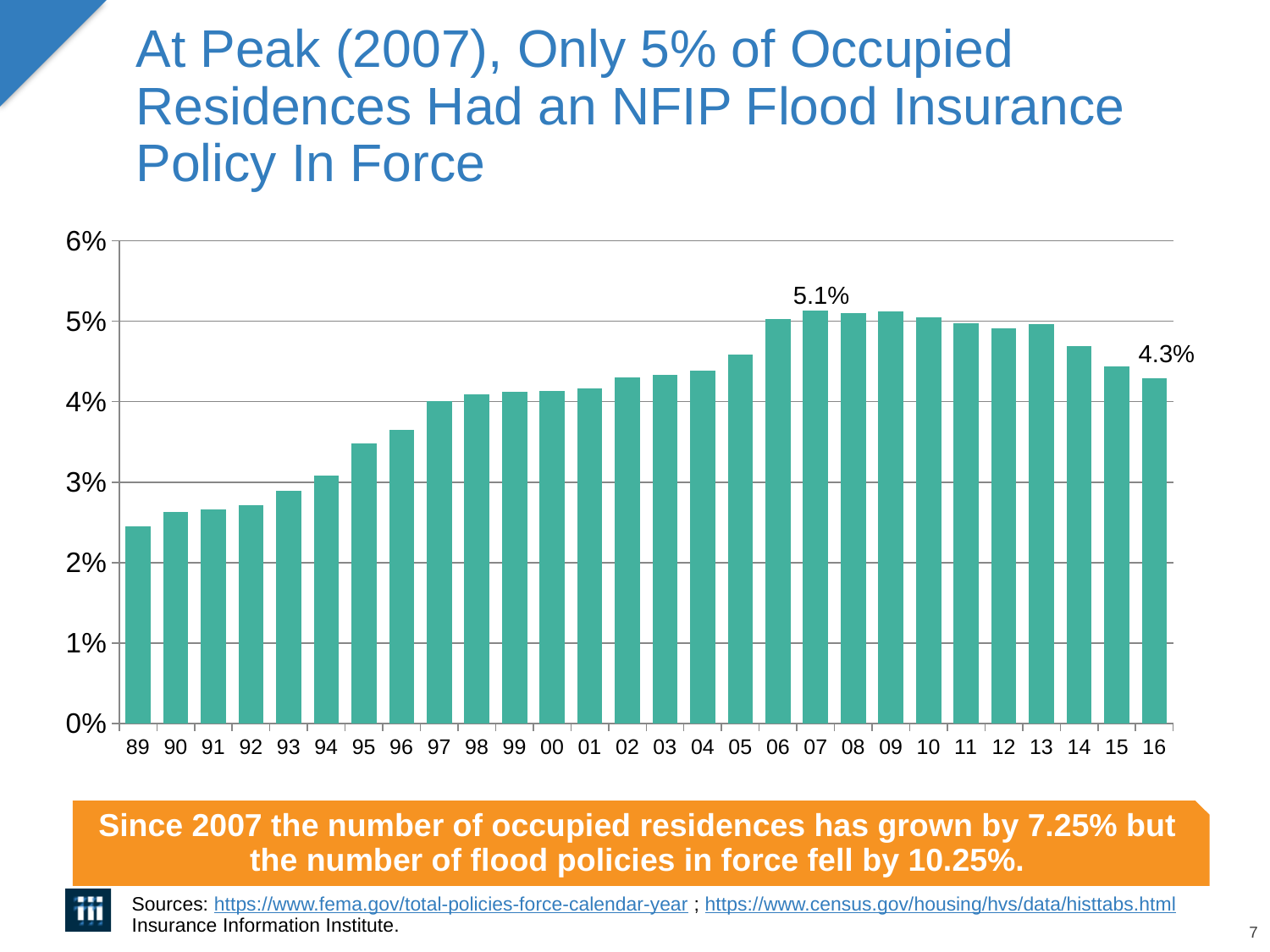
How many years are shown on the x axis? 28 Is the value for 95 greater or less than 4%? less Which is larger, the value for 89 or the value for 16? 16 What is the value shown for 07? 5.1% Which year has the highest bar? 07 Is the value for 14 greater or less than 4%? greater Which year has the lowest bar? 89 What kind of chart is shown on the slide? Bar chart What is the difference between the labeled values for 07 and 16? 0.8 percentage points Is the value for 89 greater or less than 3%? less What is the value shown for 16? 4.3% Do the values rise or fall from 89 to 07? Rise